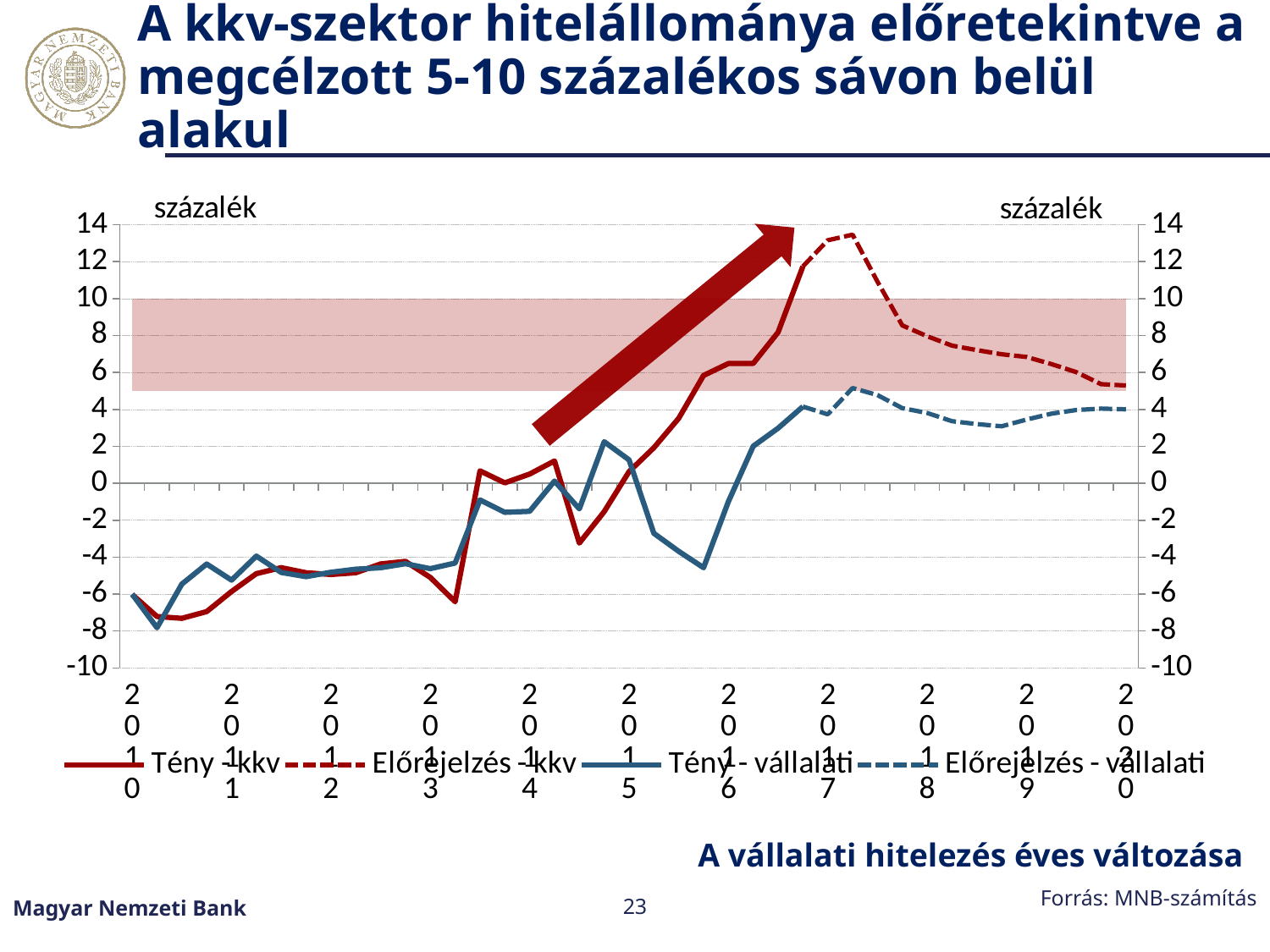
Is the value of Előrejelzés - kkv at 2020 greater or less than 4? greater Is the value of Előrejelzés - vállalati at 2020 greater or less than 2? greater What kind of chart is shown on the slide? line chart What are the four series named in the legend? Tény - kkv, Előrejelzés - kkv, Tény - vállalati, Előrejelzés - vállalati Which series reaches the highest value on the chart? Előrejelzés - kkv Does the Előrejelzés - kkv line rise or fall between 2018 and 2020? fall How many year labels are shown along the x axis? 11 At 2018, which is larger: Előrejelzés - kkv or Előrejelzés - vállalati? Előrejelzés - kkv How many series does the legend list? 4 Is the peak value of Tény - kkv around 2017 greater or less than 10? greater What unit is shown on the vertical axes of the chart? százalék